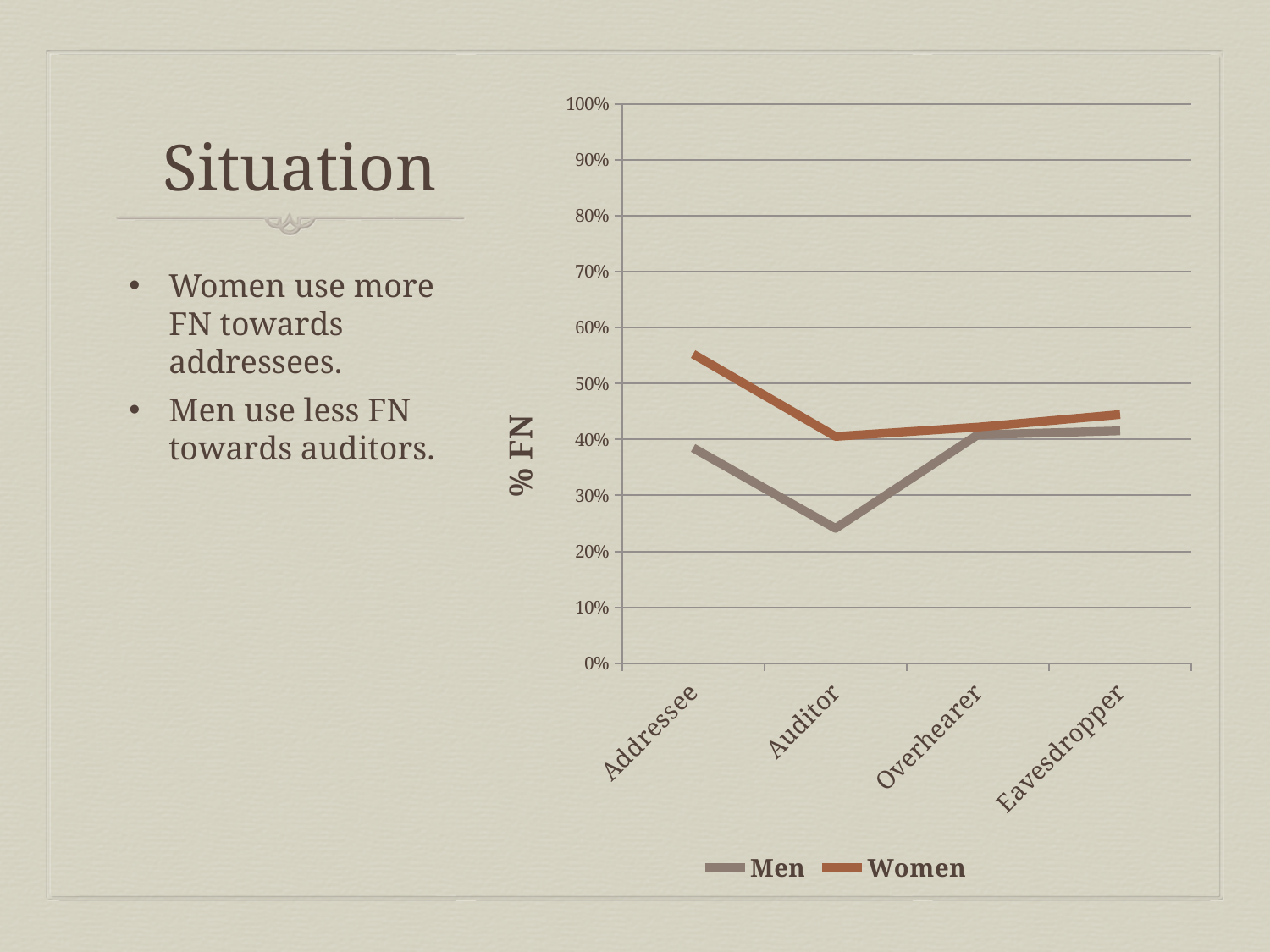
Is the value for Women at Addressee greater or less than 50%? greater Which series has the higher value for Auditor, Men or Women? Women Does the Men series rise or fall from Auditor to Overhearer? rise Which series has the higher value for Addressee, Men or Women? Women What is the label on the vertical axis of the chart? % FN How many series does the chart's legend list? 2 What kind of chart is shown on the slide? line chart How many categories are shown on the x axis of the chart? 4 For the Women series, which category has the highest value? Addressee Is the value for Men at Auditor greater or less than 30%? less For the Men series, which category has the lowest value? Auditor